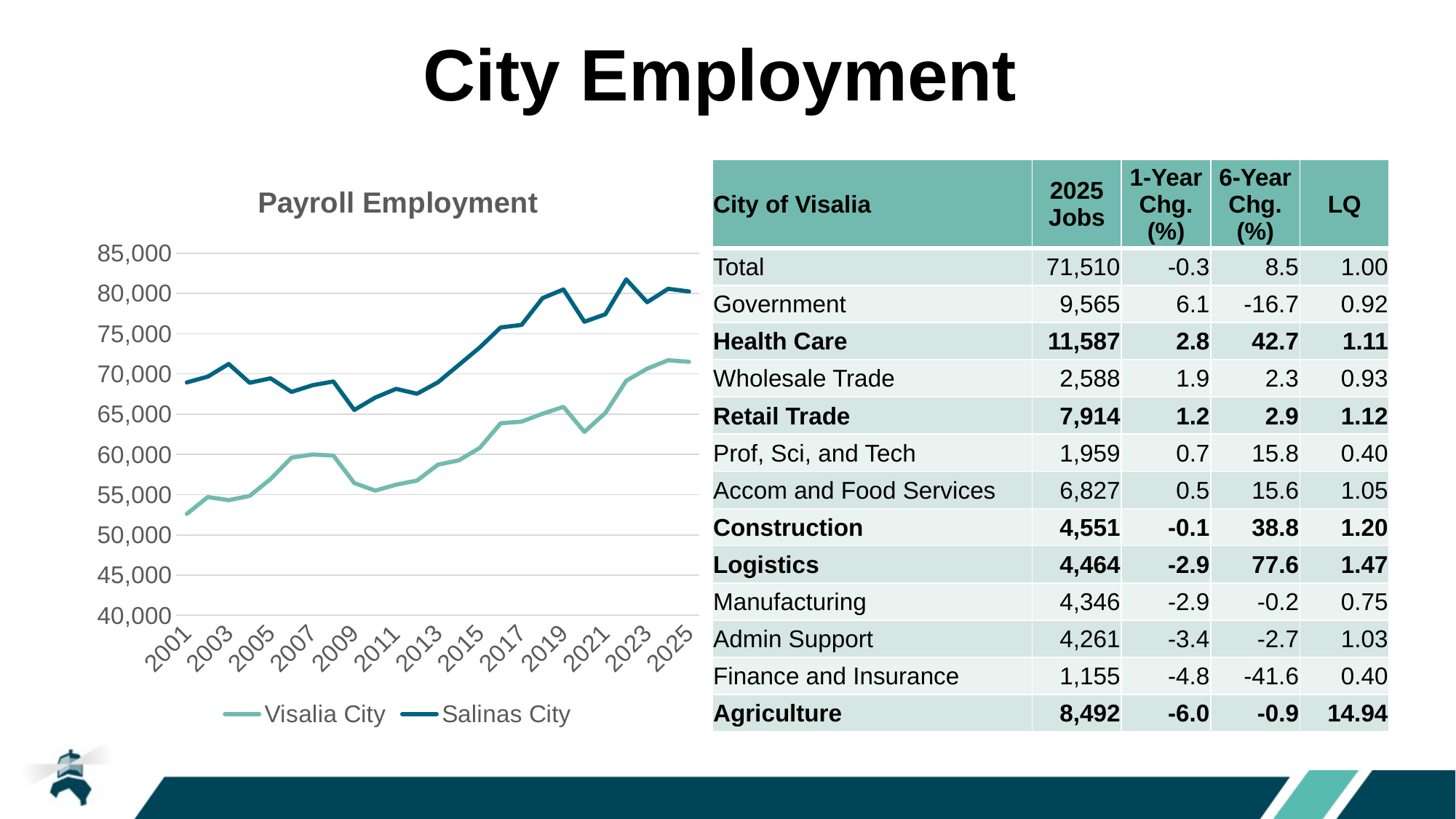
In the Payroll Employment chart, which series has the higher value in 2025, Visalia City or Salinas City? Salinas City What kind of chart is the Payroll Employment chart? line chart In the Payroll Employment chart, is the Visalia City value for 2001 greater or less than 55,000? less In the Payroll Employment chart, in which year is the Salinas City series at its lowest? 2009 What are the two series shown in the Payroll Employment chart? Visalia City and Salinas City What is the title of the line chart on the slide? Payroll Employment In the Payroll Employment chart, is the Visalia City value for 2025 greater or less than 70,000? greater In the Payroll Employment chart, is the Salinas City value for 2001 greater or less than 65,000? greater How many series does the legend of the Payroll Employment chart list? 2 In the Payroll Employment chart, in which year is the Visalia City series at its lowest? 2001 In the Payroll Employment chart, does the Visalia City series generally rise or fall from 2001 to 2025? rise